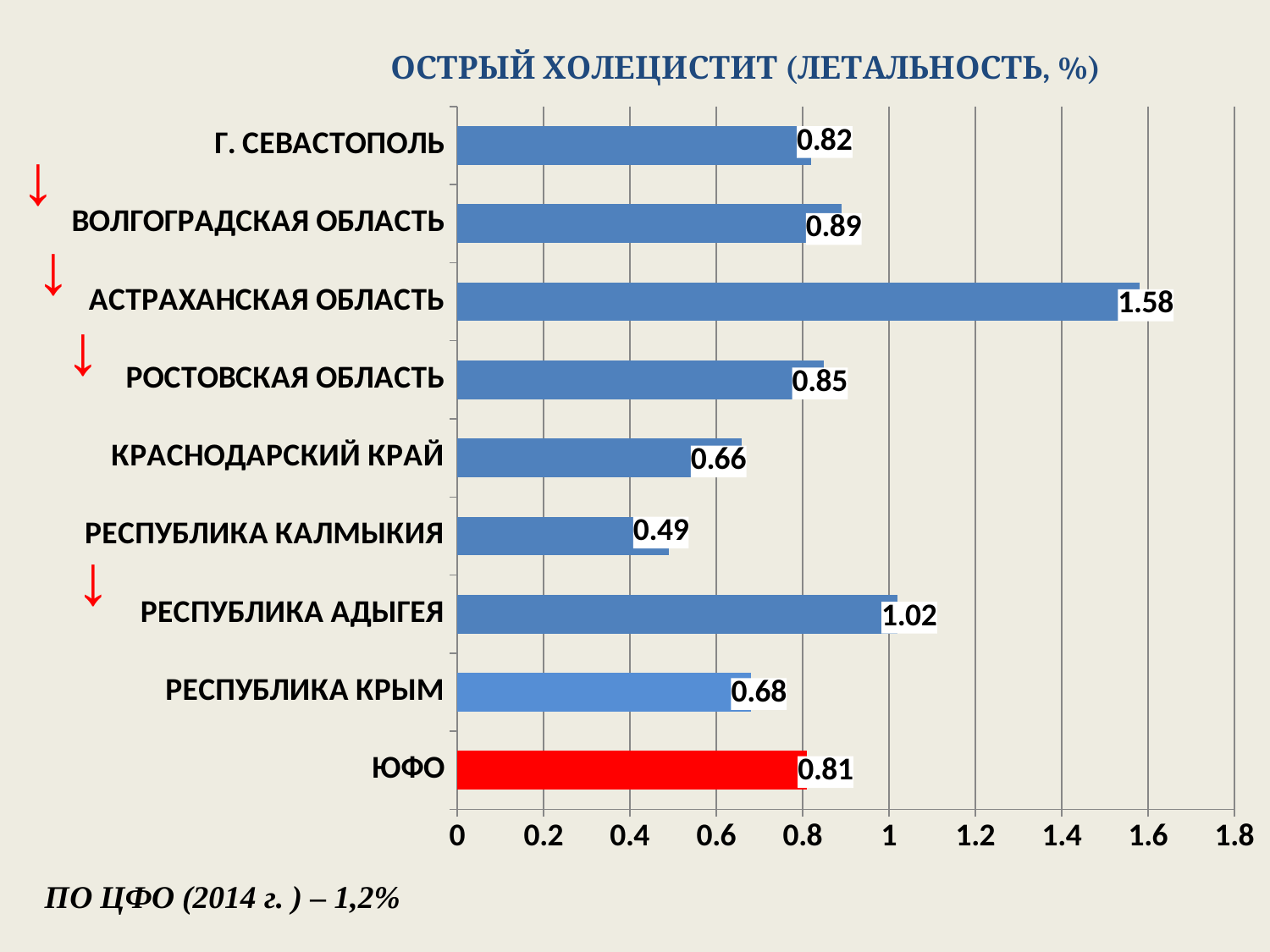
Which category has the lowest value? Республика Калмыкия What kind of chart is shown on the slide? bar chart How many categories are shown on the chart? 9 What is the value for ЮФО? 0.81 Which category's bar is coloured red? ЮФО Which category has the highest value? Астраханская область What is the title of the chart? ОСТРЫЙ ХОЛЕЦИСТИТ (ЛЕТАЛЬНОСТЬ, %) What is the value for Республика Калмыкия? 0.49 What is the value for Астраханская область? 1.58 Is the value for Республика Адыгея greater or less than 1? greater Which is larger, the value for Волгоградская область or the value for Ростовская область? Волгоградская область What is the difference between the values for Астраханская область and Республика Адыгея? 0.56